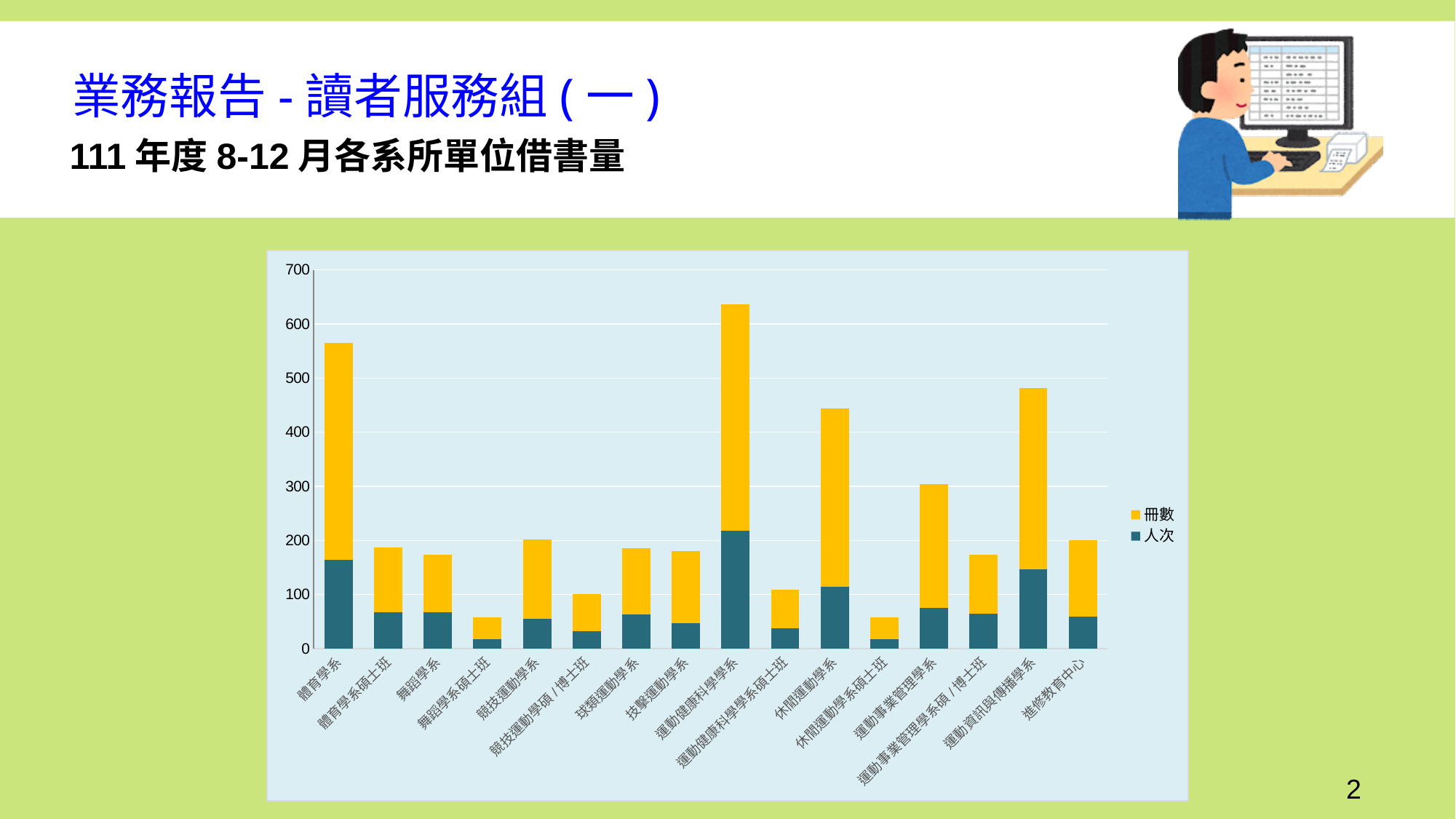
What are the two series named in the legend? 冊數 and 人次 How many departments/units are shown along the x axis? 16 Is the total bar for 體育學系 greater or less than 500? greater Is the total bar for 運動資訊與傳播學系 greater or less than 500? less Which has the larger total bar, 體育學系 or 休閒運動學系? 體育學系 Is the total bar for 休閒運動學系 greater or less than 400? greater Which department has the highest total bar? 運動健康科學學系 Which department has the highest 人次 value? 運動健康科學學系 How many series does the legend list? 2 What kind of chart is shown on the slide? bar chart